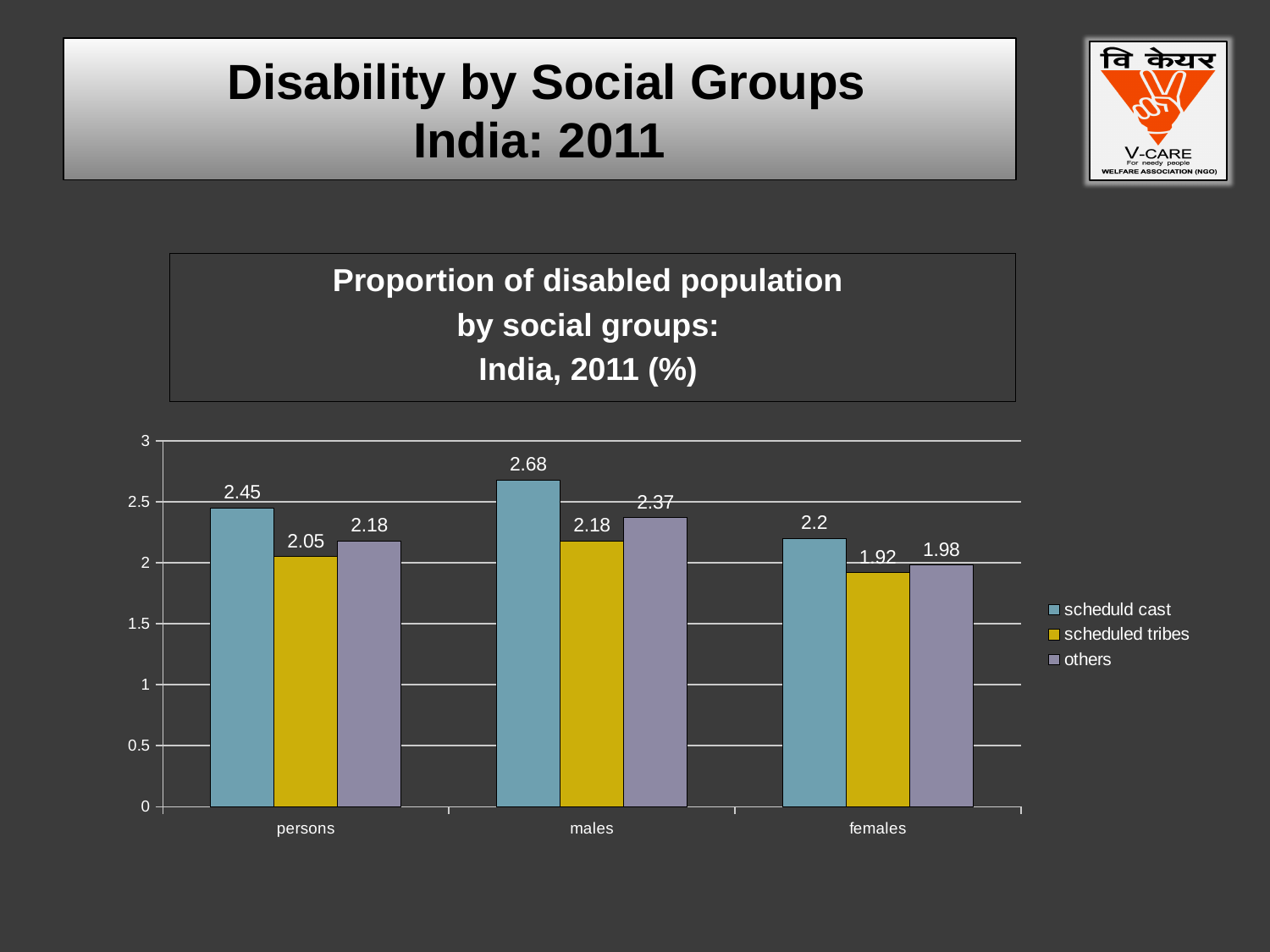
How many series does the legend list? 3 Which category has the lowest value for the others series? females What is the value for others among persons? 2.18 What kind of chart is shown on the slide? bar chart How many categories are shown on the x axis? 3 What is the value for scheduled cast among males? 2.68 Is the value for scheduled cast among persons greater or less than 2? greater Which is larger for persons: the scheduled tribes value or the others value? others What is the difference between the scheduled cast value for males and the scheduled cast value for females? 0.48 Which category has the highest value for the scheduled cast series? males What is the value for scheduled tribes among females? 1.92 What is the title of the chart? Proportion of disabled population by social groups: India, 2011 (%)